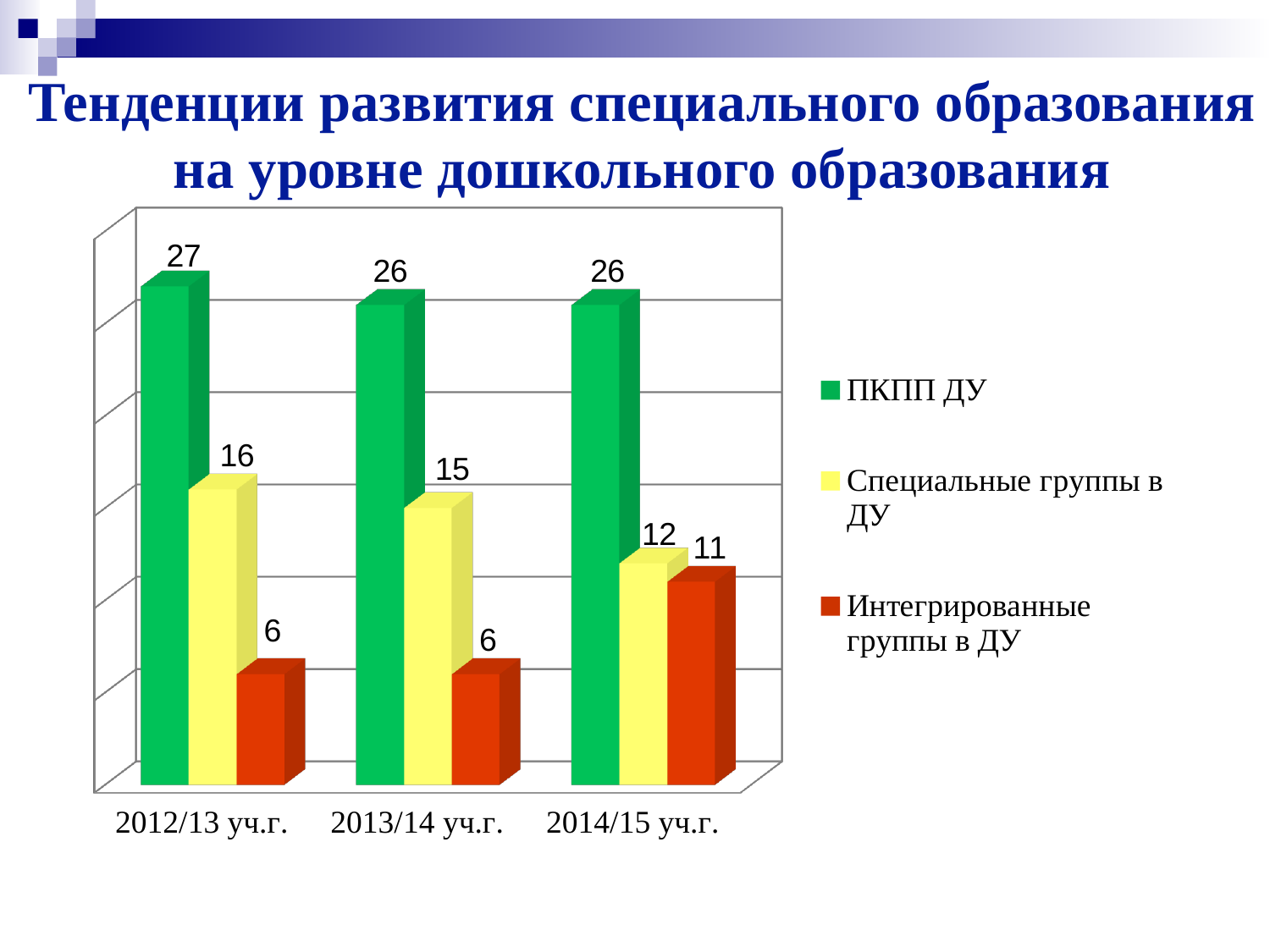
In which year is the value for Специальные группы в ДУ the lowest? 2014/15 уч.г. By how much did Интегрированные группы в ДУ increase from 2013/14 уч.г. to 2014/15 уч.г.? 5 How many years (categories) are shown on the x axis? 3 What is the value for Интегрированные группы в ДУ in 2014/15 уч.г.? 11 Which is larger in 2014/15 уч.г.: Специальные группы в ДУ or Интегрированные группы в ДУ? Специальные группы в ДУ What is the value for Специальные группы в ДУ in 2013/14 уч.г.? 15 What kind of chart is shown on the slide? Bar chart Does the value for Специальные группы в ДУ rise or fall from 2012/13 уч.г. to 2014/15 уч.г.? Fall How many series does the legend list? 3 What is the value for ПКПП ДУ in 2012/13 уч.г.? 27 In which year is the value for ПКПП ДУ the highest? 2012/13 уч.г. What is the difference between ПКПП ДУ and Интегрированные группы в ДУ in 2012/13 уч.г.? 21